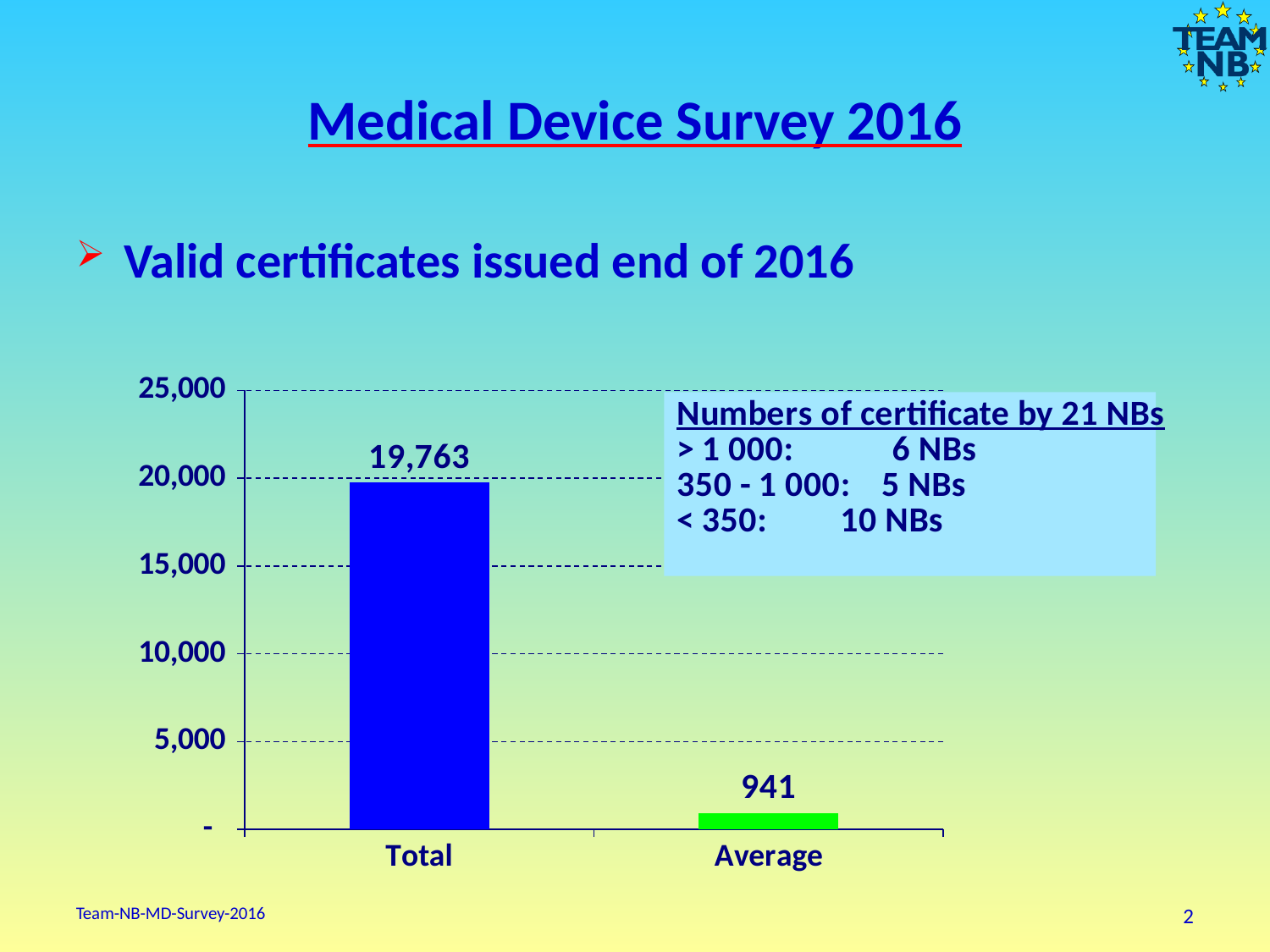
What is the difference between the Total and Average values? 18,822 What is the value of the Average bar? 941 Is the value for Total greater or less than 20,000? less Which is larger, the Total bar or the Average bar? Total What kind of chart is shown on the slide? bar chart What is the value of the Total bar? 19,763 How many categories are shown on the x axis? 2 Which category has the lowest value? Average Is the value for Average greater or less than 5,000? less Which category has the highest value? Total What is the highest value shown on the y axis? 25,000 What colour is the Average bar? green